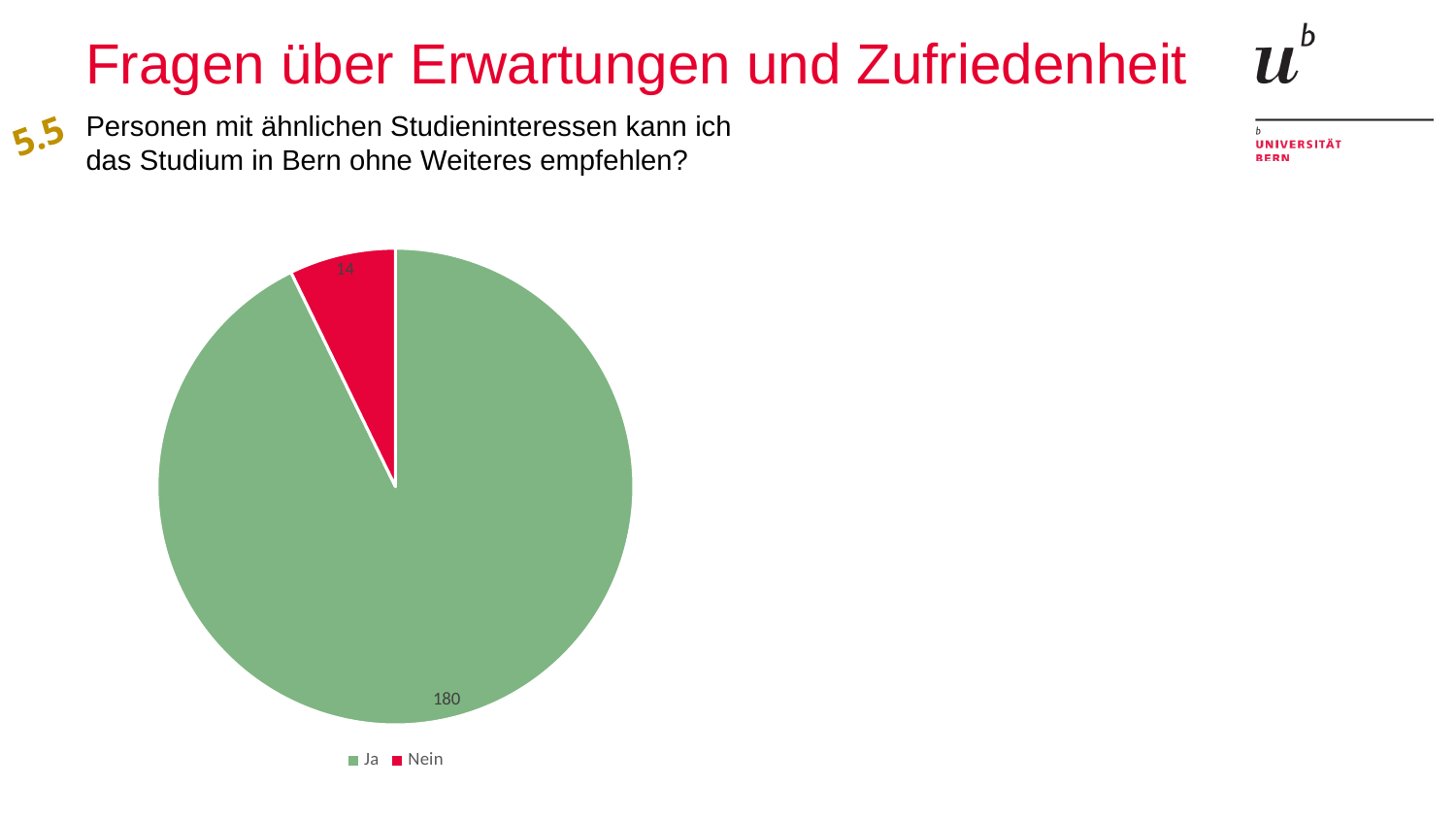
What is the difference between the number of "Ja" and "Nein" answers? 166 How many respondents answered "Nein" in the pie chart? 14 Which category has the largest slice in the pie chart? Ja How many entries does the legend list? 2 What colour is the "Ja" slice in the pie chart? Green Which is larger, the "Ja" slice or the "Nein" slice? Ja What kind of chart is shown on the slide? Pie chart Which category has the smallest slice in the pie chart? Nein What is the total number of responses shown in the pie chart? 194 How many categories does the pie chart show? 2 What colour is the "Nein" slice in the pie chart? Red How many respondents answered "Ja" in the pie chart? 180